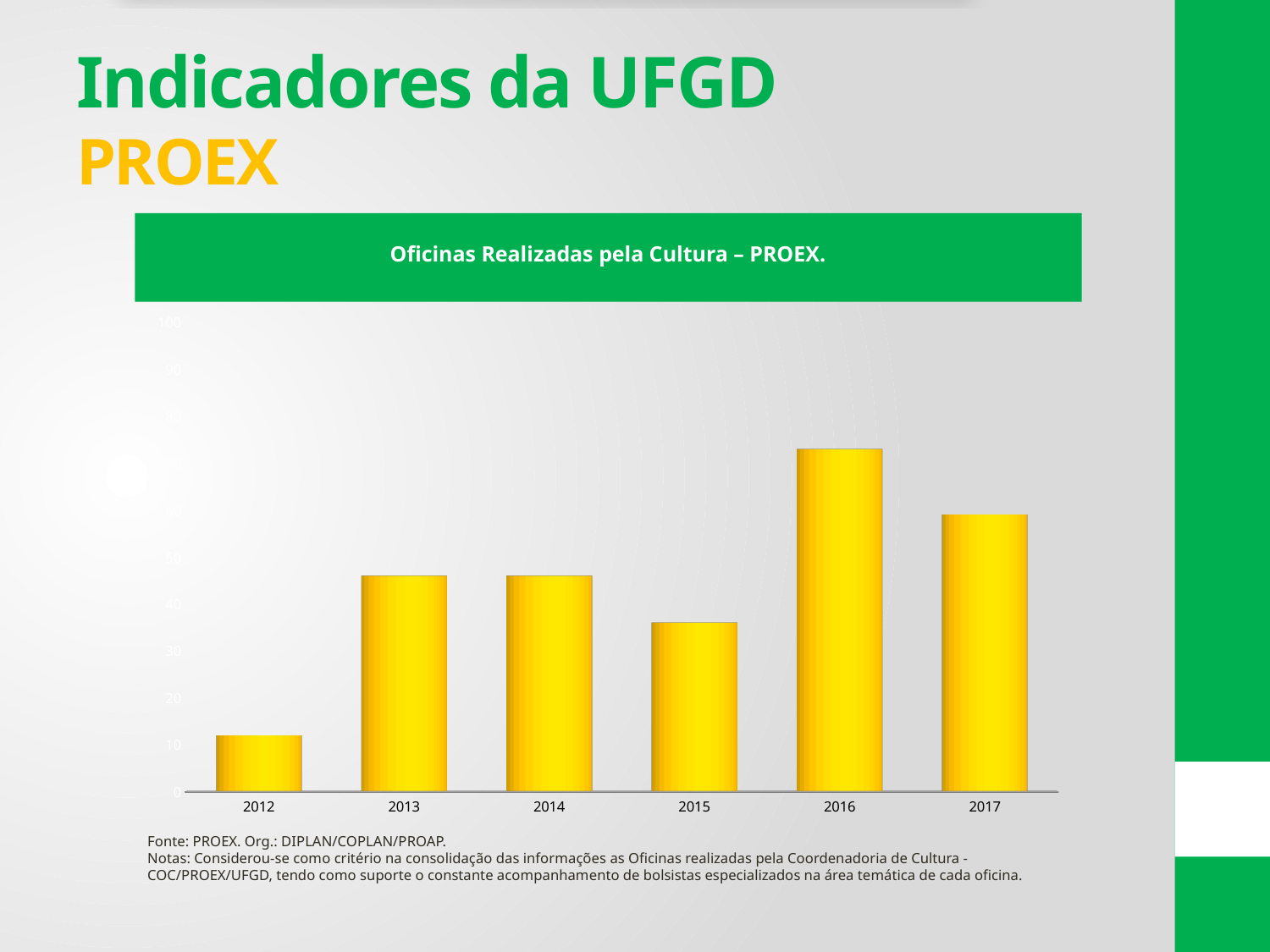
Which year has the lowest bar? 2012 How many years are shown on the x axis of the chart? 6 Is the value for 2012 greater or less than 20? less Does the value rise or fall from 2016 to 2017? fall Which is larger, the value for 2016 or the value for 2017? 2016 Is the value for 2017 greater or less than 50? greater Which is larger, the value for 2015 or the value for 2013? 2013 What is the title of the chart? Oficinas Realizadas pela Cultura – PROEX. What kind of chart is shown on the slide? bar chart What colour are the bars in the chart? yellow Is the value for 2016 greater or less than 60? greater Which year has the highest bar? 2016